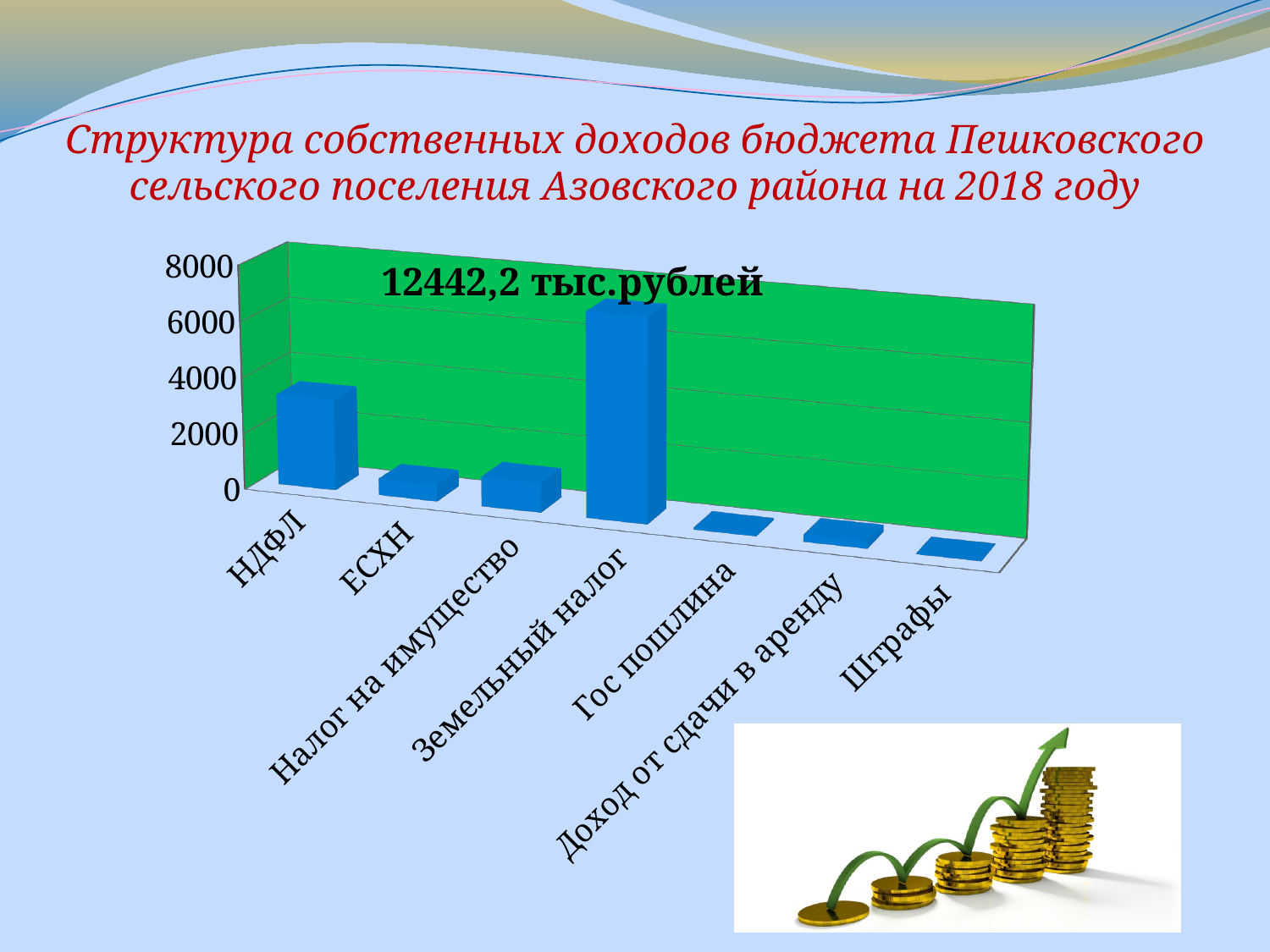
Which is larger, the value for НДФЛ or the value for ЕСХН? НДФЛ Is the value for НДФЛ greater or less than 4000? less Is the value for НДФЛ greater or less than 2000? greater Is the value for Штрафы greater or less than 2000? less Which is larger, the value for Земельный налог or the value for НДФЛ? Земельный налог What kind of chart is shown on the slide? bar chart Which category has the highest value in the chart? Земельный налог What total amount is printed as text inside the chart area? 12442,2 тыс.рублей What is the highest tick value shown on the vertical axis of the chart? 8000 How many categories are shown on the x axis of the chart? 7